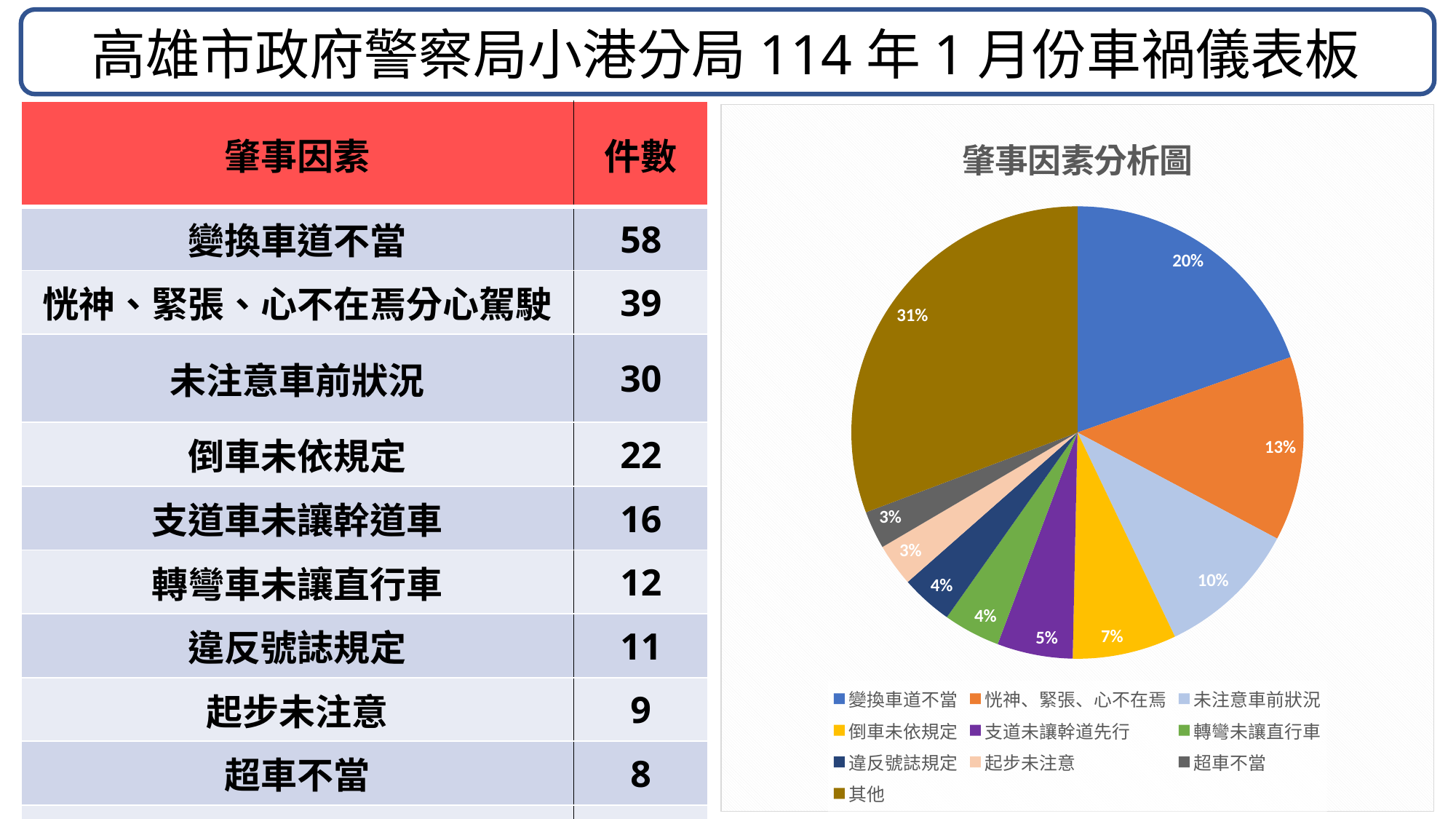
What share of the pie does the 其他 slice represent? 31% How many slices does the pie chart have? 10 What kind of chart is shown on the slide? pie chart What is the title of the chart? 肇事因素分析圖 What is the difference in percentage points between the 變換車道不當 slice and the 恍神、緊張、心不在焉 slice? 7 How many entries does the chart legend list? 10 Which slice is the largest in the pie chart? 其他 What percentage does the 倒車未依規定 slice show? 7% What percentage does the 變換車道不當 slice show? 20% Which is larger, the 變換車道不當 slice or the 恍神、緊張、心不在焉 slice? 變換車道不當 What percentage does the 未注意車前狀況 slice show? 10% What percentage does the 恍神、緊張、心不在焉 slice show? 13%